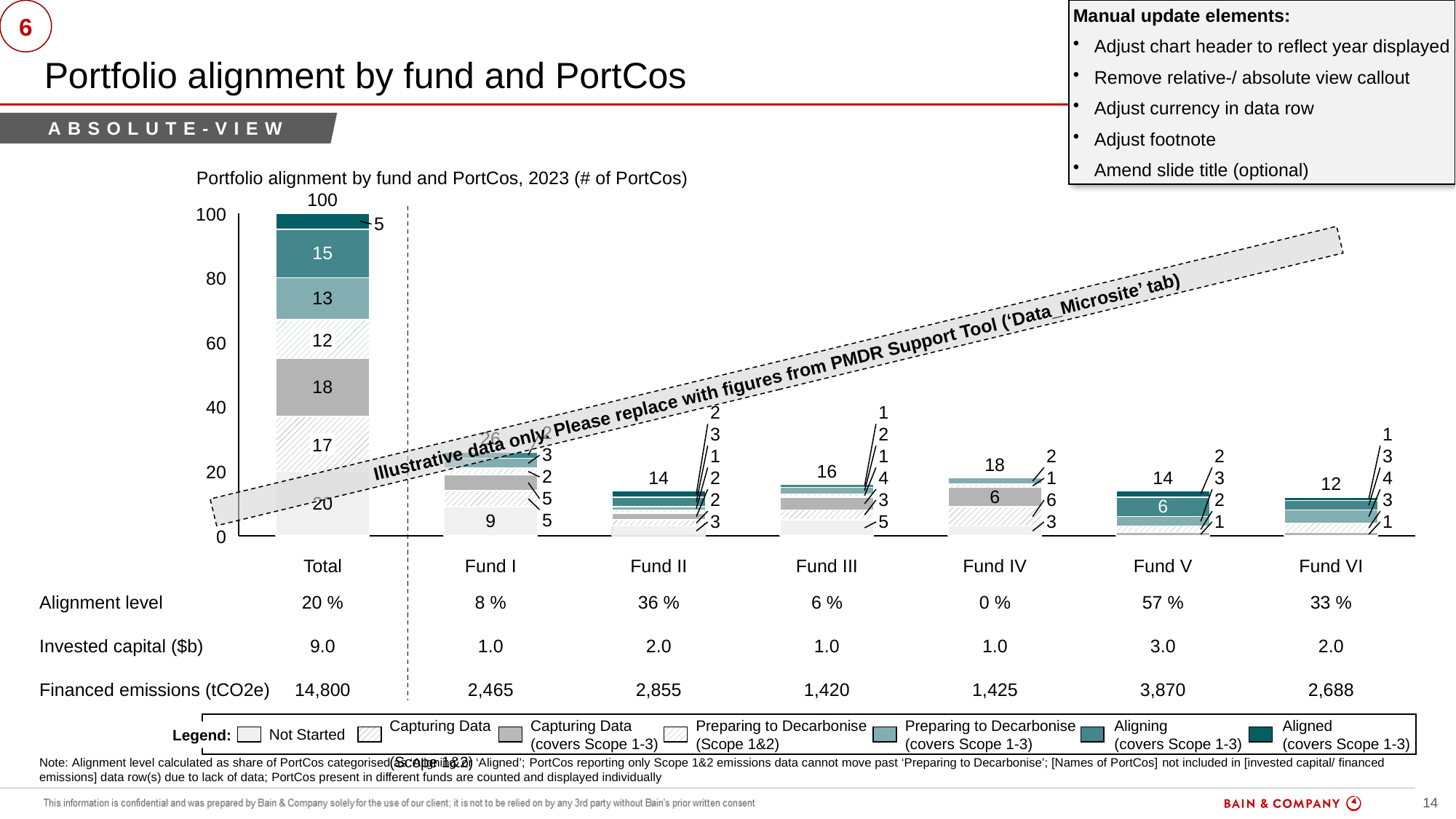
What is the title of the chart? Portfolio alignment by fund and PortCos, 2023 (# of PortCos) Which has a larger total number of PortCos, Fund II or Fund III? Fund III How many series does the chart legend list? 7 How many PortCos in the Total bar are in the Aligned (covers Scope 1-3) segment? 5 In the Total bar, what is the difference between the Capturing Data (covers Scope 1-3) segment and the Preparing to Decarbonise (Scope 1&2) segment? 6 Among the individual funds (Fund I to Fund VI), which has the lowest total number of PortCos? Fund VI How many categories are shown along the x axis of the chart? 7 How many PortCos in the Total bar are in the Not Started segment? 20 How many PortCos in the Total bar are in the Aligning (covers Scope 1-3) segment? 15 How many PortCos in Fund I are in the Not Started segment? 9 What is the total number of PortCos shown on top of the Total bar? 100 What kind of chart is shown on the slide? Stacked bar chart